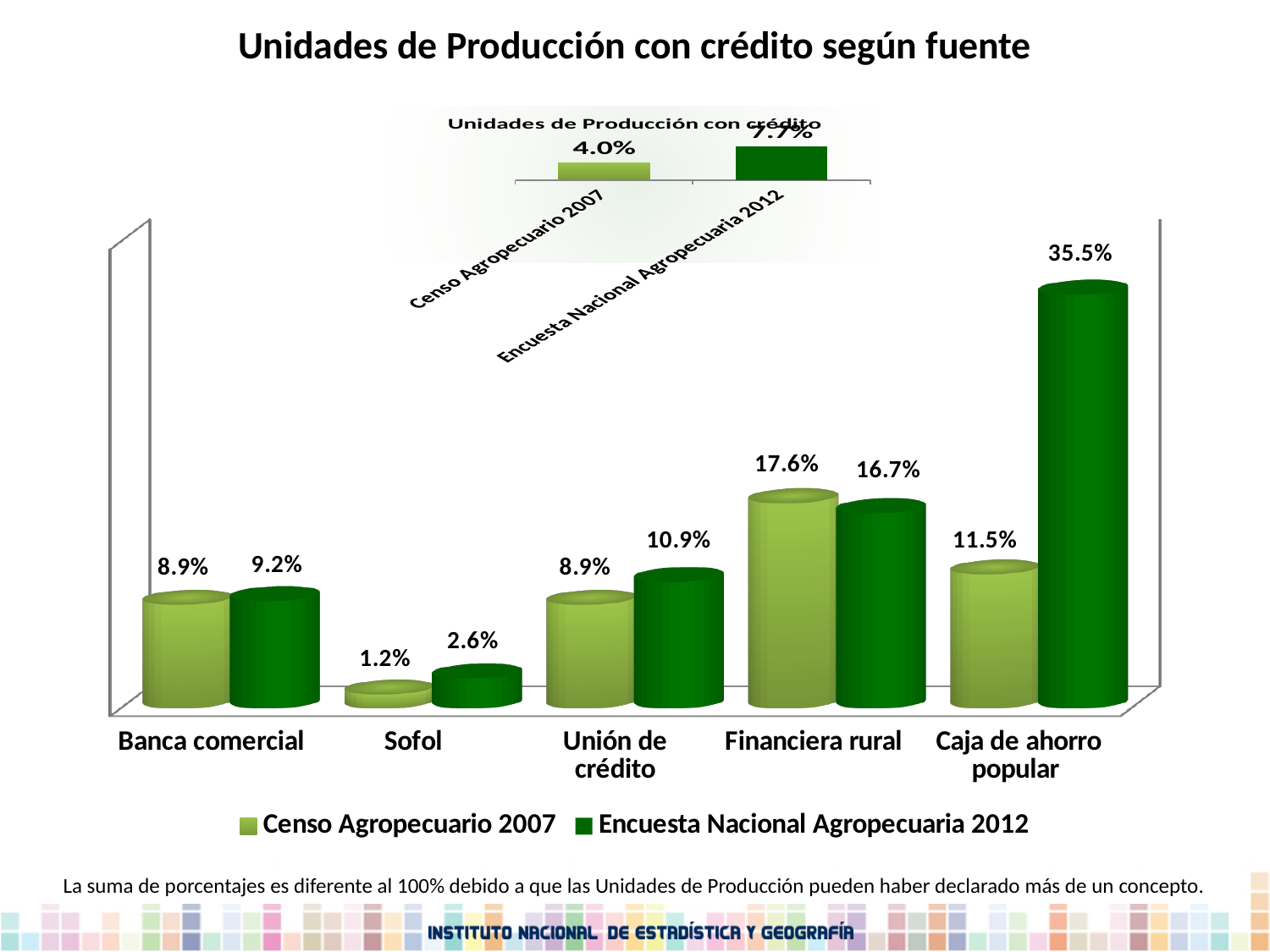
In the main chart 'Unidades de Producción con crédito según fuente', which category has the lowest value in the Censo Agropecuario 2007 series? Sofol How many series does the legend of the main chart 'Unidades de Producción con crédito según fuente' list? 2 In the main chart 'Unidades de Producción con crédito según fuente', what is the value for Financiera rural in the Censo Agropecuario 2007 series? 17.6% In the main chart 'Unidades de Producción con crédito según fuente', what is the value for Caja de ahorro popular in the Encuesta Nacional Agropecuaria 2012 series? 35.5% What kind of chart is the main chart 'Unidades de Producción con crédito según fuente'? Bar chart In the main chart 'Unidades de Producción con crédito según fuente', what is the value for Sofol in the Censo Agropecuario 2007 series? 1.2% In the small inset chart 'Unidades de Producción con crédito', what is the value for Encuesta Nacional Agropecuaria 2012? 7.7% In the small inset chart 'Unidades de Producción con crédito', what is the difference between the Encuesta Nacional Agropecuaria 2012 value and the Censo Agropecuario 2007 value? 3.7% How many categories are shown on the x axis of the main chart 'Unidades de Producción con crédito según fuente'? 5 In the main chart 'Unidades de Producción con crédito según fuente', what is the difference between the 2012 and 2007 values for Caja de ahorro popular? 24.0% In the main chart 'Unidades de Producción con crédito según fuente', which is larger for Financiera rural: the Censo Agropecuario 2007 value or the Encuesta Nacional Agropecuaria 2012 value? Censo Agropecuario 2007 In the main chart 'Unidades de Producción con crédito según fuente', which category has the highest value in the Encuesta Nacional Agropecuaria 2012 series? Caja de ahorro popular